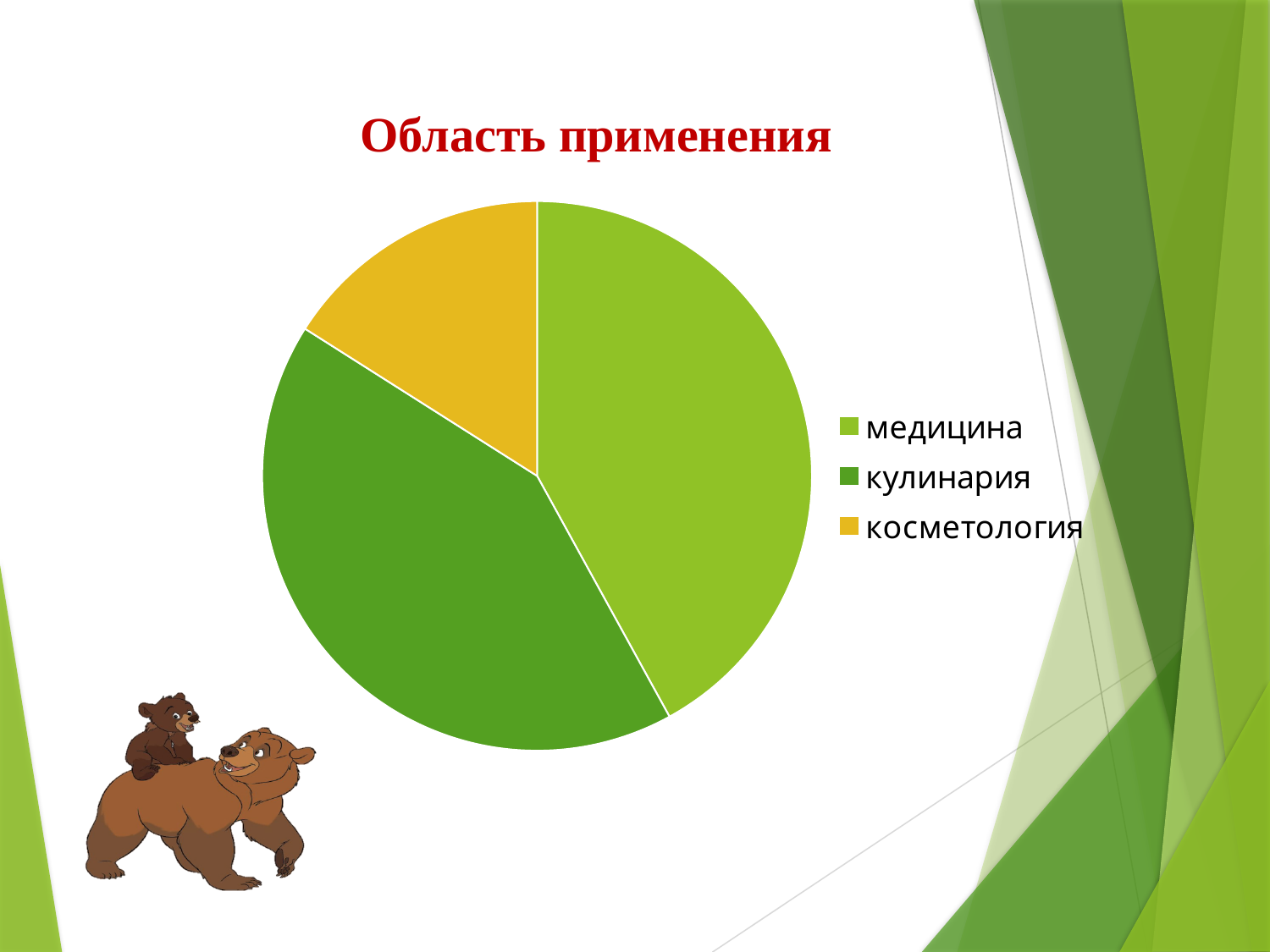
How many slices does the pie chart have? 3 What kind of chart is shown on the slide? pie chart What is the title of the slide with the pie chart? Область применения What colour is the косметология slice in the pie chart? yellow Which category has the smallest slice in the pie chart? косметология Which slice is larger, медицина or косметология? медицина How many entries does the legend of the pie chart list? 3 Which slice is larger, кулинария or косметология? кулинария